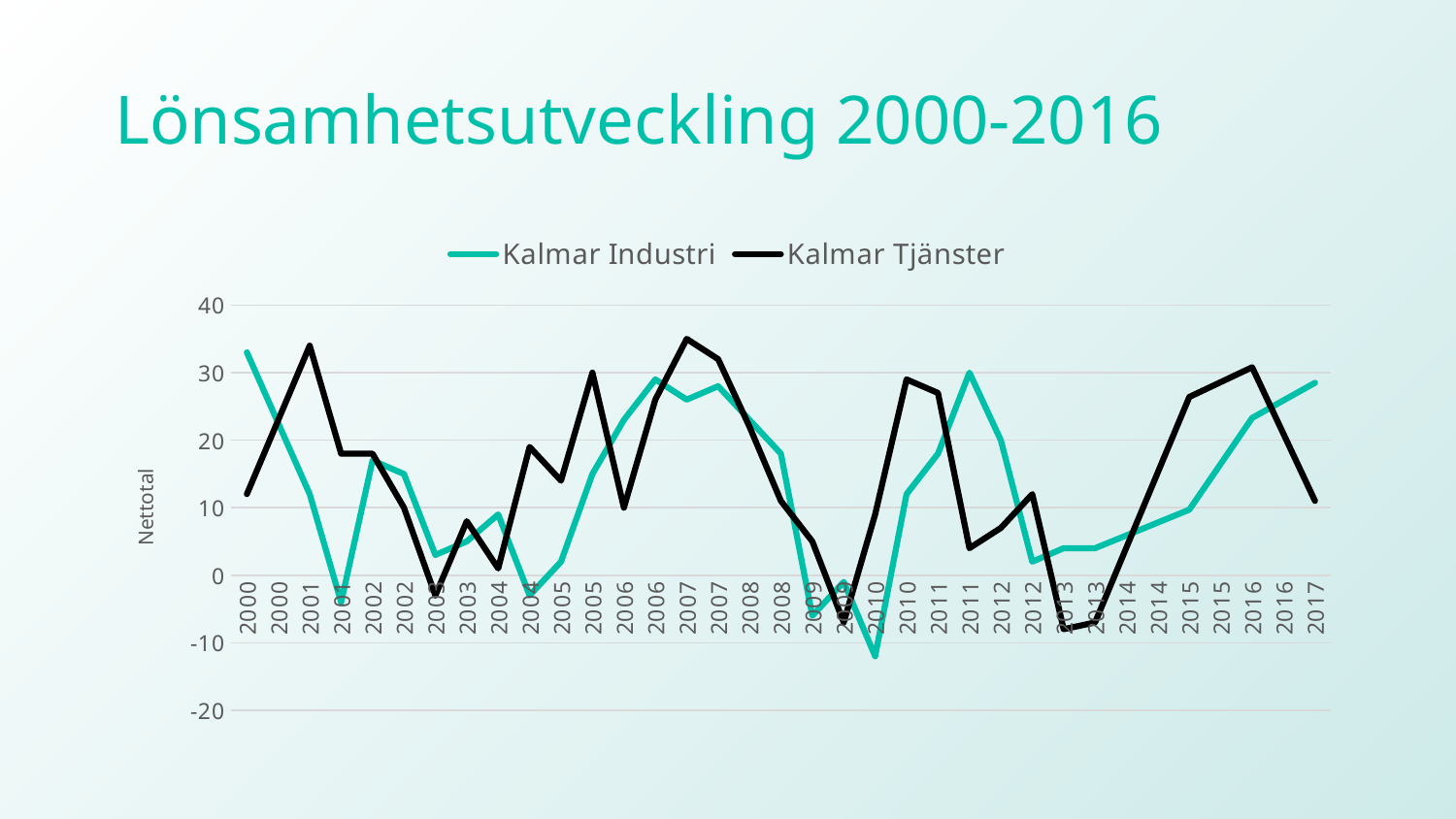
Is the lowest value for Kalmar Industri, at 2010, greater or less than 0? less Is the value for Kalmar Industri at 2017 greater or less than 20? greater How many points are plotted along the x axis for each series? 35 Is the value for Kalmar Tjänster at 2017 greater or less than 20? less At the first 2000 point, which series has the larger value, Kalmar Industri or Kalmar Tjänster? Kalmar Industri What is the title of the chart on the slide? Lönsamhetsutveckling 2000-2016 How many series does the legend list? 2 In which year does Kalmar Industri reach its lowest value? 2010 What kind of chart is shown on the slide? line chart What is the label on the vertical axis? Nettotal